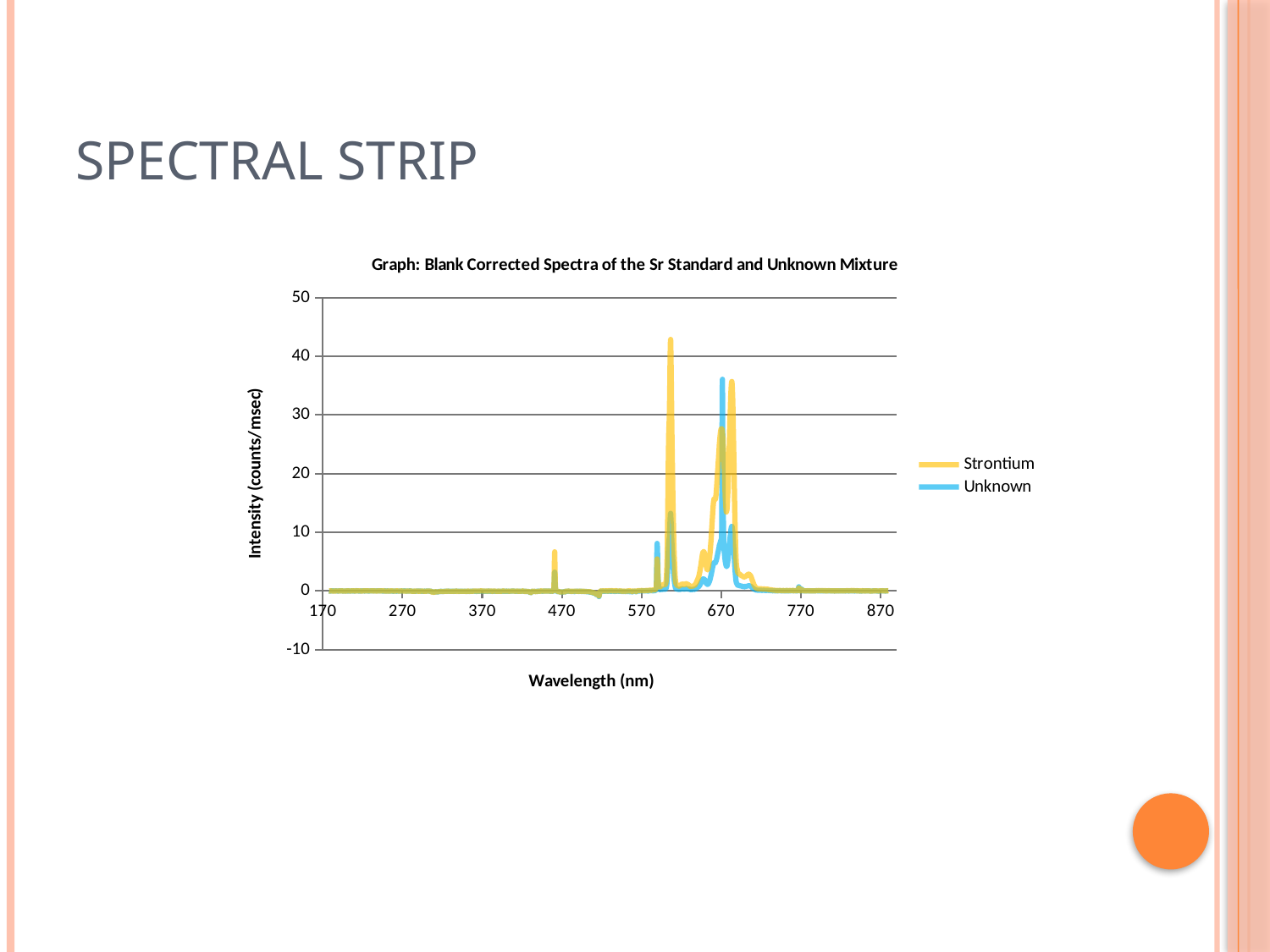
What kind of chart is shown on the slide? Line chart What is the title of the chart? Graph: Blank Corrected Spectra of the Sr Standard and Unknown Mixture Is the Strontium peak near 470 nm greater or less than 10 counts/msec? less Is the highest peak of the Unknown series greater or less than 40 counts/msec? less What is the label of the y axis? Intensity (counts/msec) What is the lowest value shown on the y axis? -10 How many series does the legend list? 2 Is the highest peak of the Unknown series greater or less than 30 counts/msec? greater What is the label of the x axis? Wavelength (nm) What are the two series named in the legend? Strontium and Unknown Which series reaches the highest peak intensity on the chart? Strontium